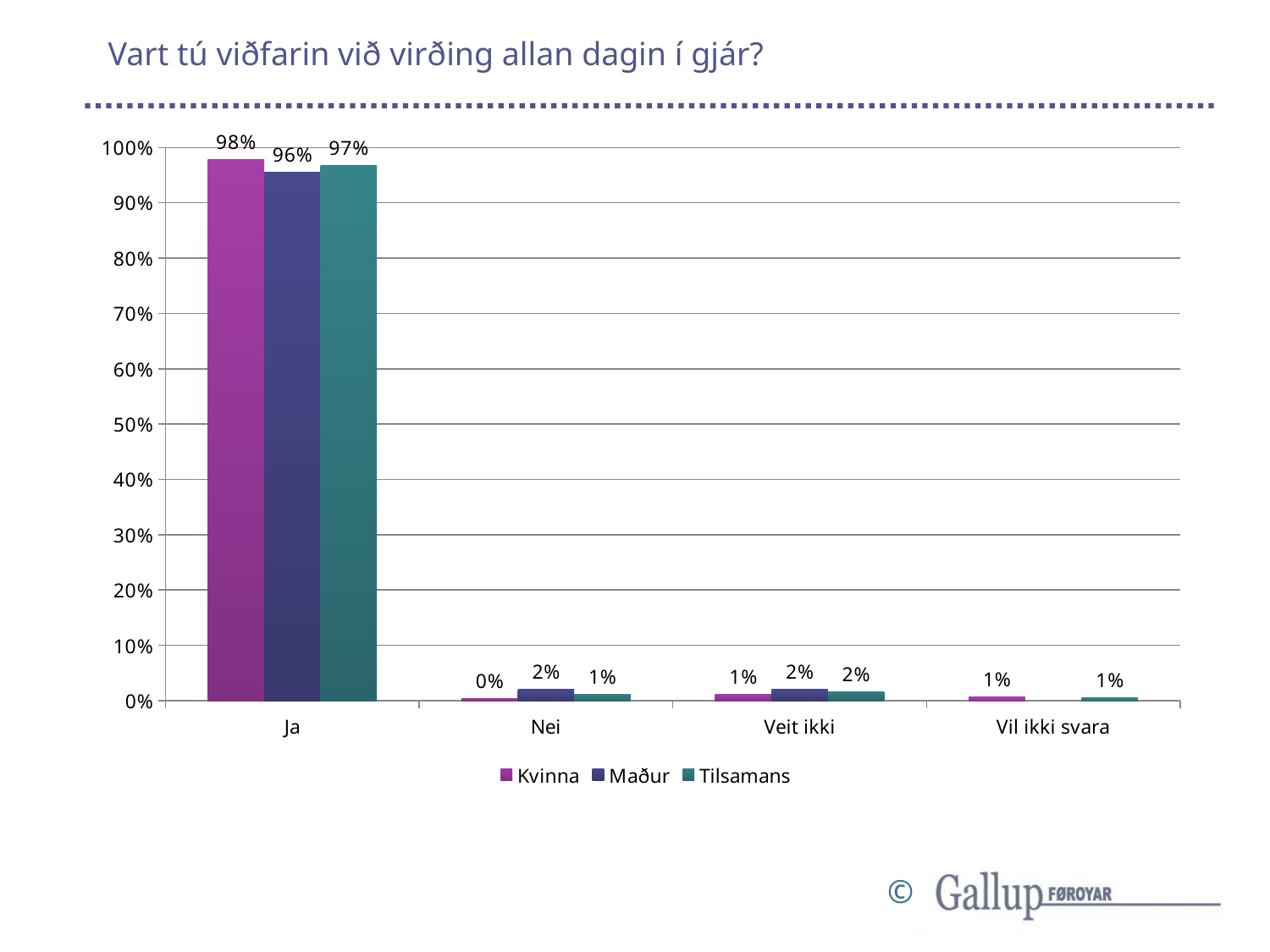
What is the value for Tilsamans in the Nei category? 1% What kind of chart is shown on the slide? bar chart What is the value for Kvinna in the Ja category? 98% What is the title of the chart? Vart tú viðfarin við virðing allan dagin í gjár? What is the value for Maður in the Veit ikki category? 2% How many categories are shown on the x axis? 4 What is the difference between the Kvinna and Maður values in the Ja category? 2% Which category has the highest value for Tilsamans? Ja Is the value for Tilsamans in the Ja category greater or less than 90%? greater Which is larger in the Ja category, the Kvinna value or the Maður value? Kvinna What is the value for Maður in the Ja category? 96% How many series does the legend list? 3